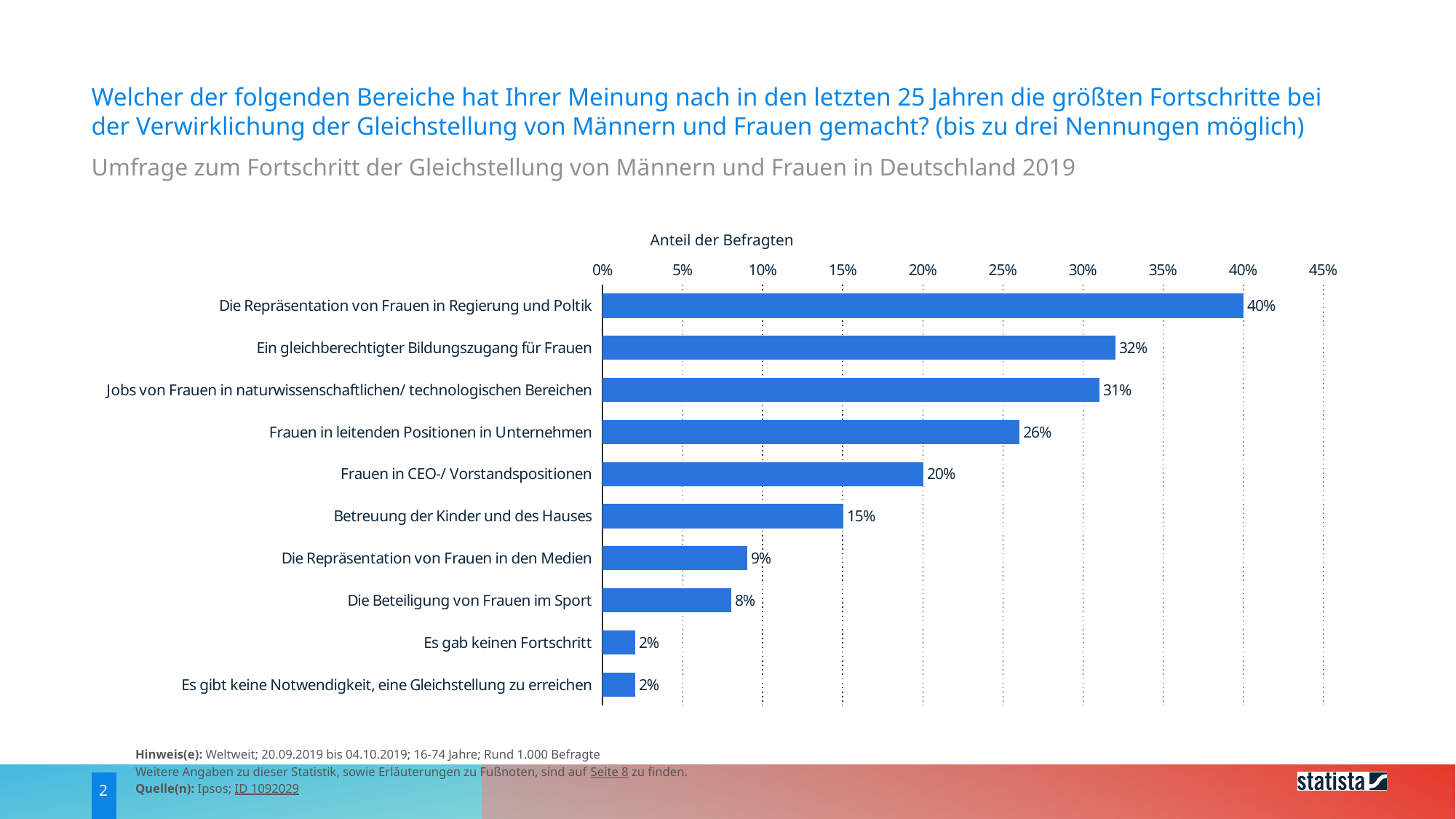
What is the value for "Frauen in CEO-/ Vorstandspositionen"? 20% What kind of chart is shown on the slide? bar chart What is the difference between "Ein gleichberechtigter Bildungszugang für Frauen" and "Frauen in leitenden Positionen in Unternehmen"? 6% What is the label of the value axis? Anteil der Befragten How many categories are shown in the chart? 10 What is the value for "Die Repräsentation von Frauen in Regierung und Poltik"? 40% Which is larger: "Die Repräsentation von Frauen in den Medien" or "Die Beteiligung von Frauen im Sport"? Die Repräsentation von Frauen in den Medien What is the lowest value shown in the chart? 2% What is the difference between the highest and lowest values in the chart? 38% What is the value for "Betreuung der Kinder und des Hauses"? 15% Is the value for "Jobs von Frauen in naturwissenschaftlichen/ technologischen Bereichen" greater or less than 30%? greater Which category has the highest value? Die Repräsentation von Frauen in Regierung und Poltik